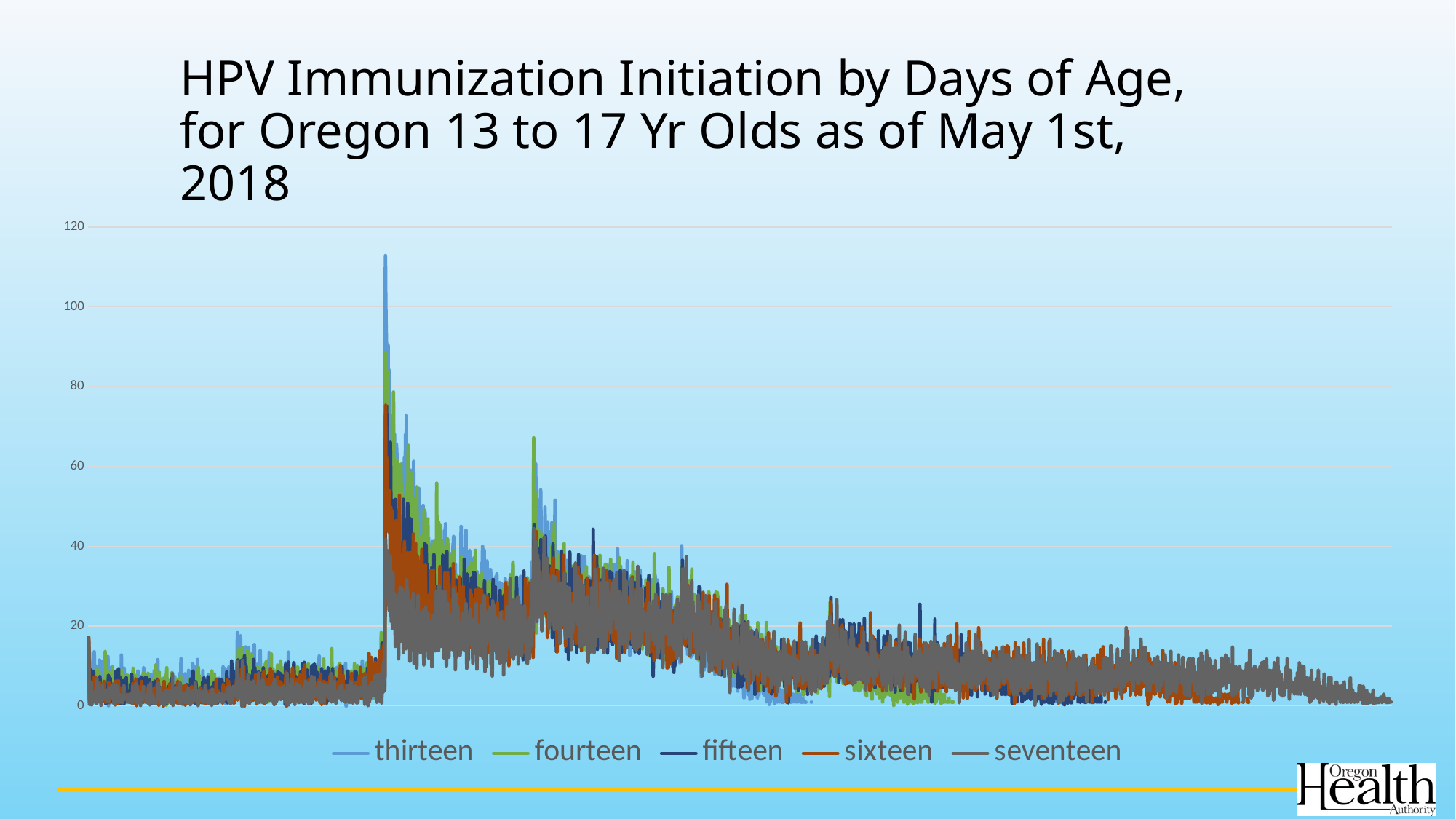
Which series are listed in the legend? thirteen, fourteen, fifteen, sixteen, seventeen What is the title of the chart? HPV Immunization Initiation by Days of Age, for Oregon 13 to 17 Yr Olds as of May 1st, 2018 Is the highest peak of the thirteen series greater or less than 100? greater Which series extends furthest to the right along the x axis? seventeen Is the highest peak of the fourteen series greater or less than 80? greater Is the highest peak of the seventeen series greater or less than 60? less How many series does the legend list? 5 Which series reaches the highest peak on the chart? thirteen After the large spike, do the values generally rise or fall moving to the right along the x axis? fall What kind of chart is shown on the slide? Line chart What is the highest value shown on the vertical axis? 120